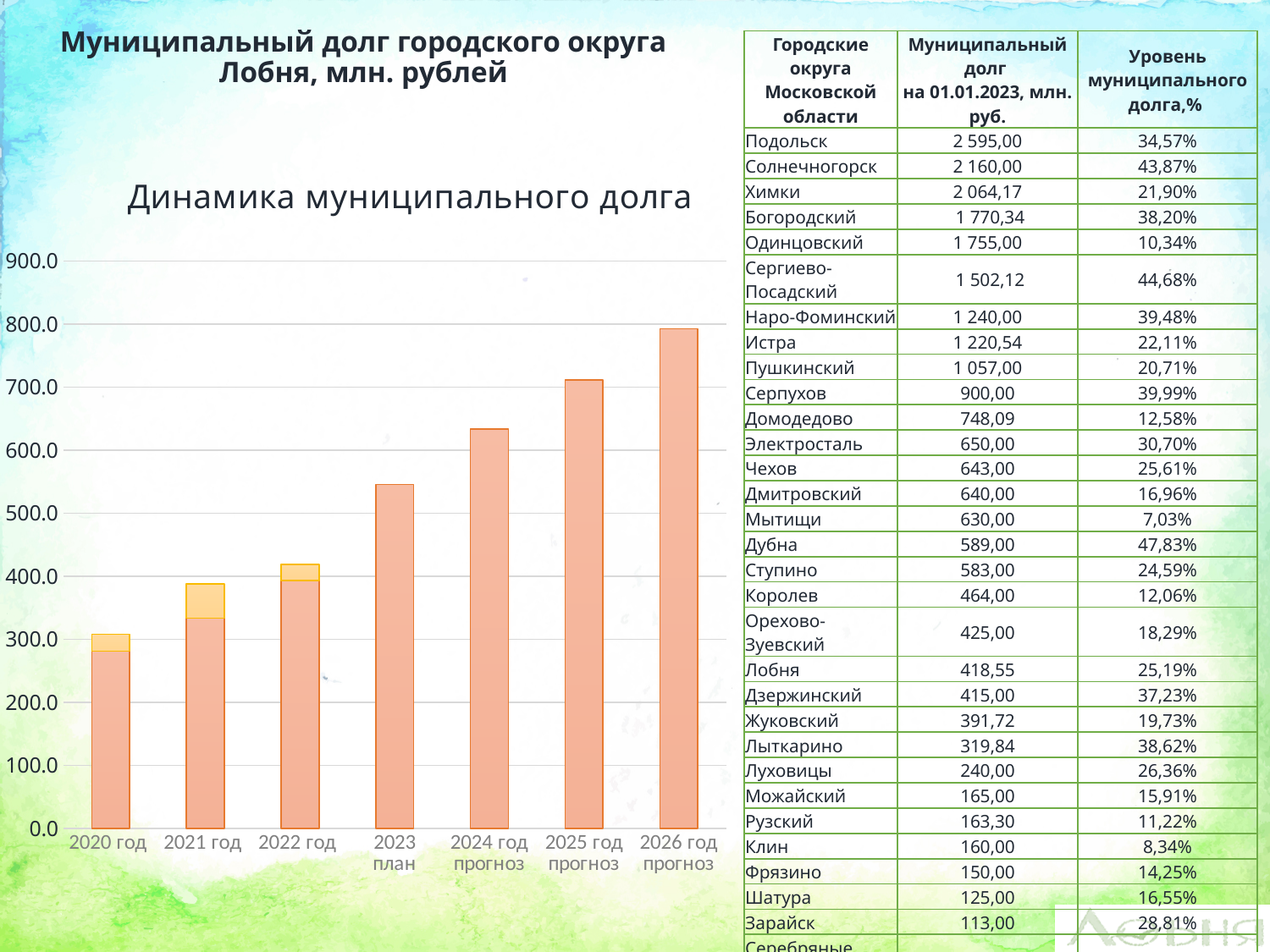
Do the bar values rise or fall from 2020 год to 2026 год прогноз? rise What is the title of the chart? Динамика муниципального долга Is the value for 2025 год прогноз greater or less than 800.0? less Is the value for 2026 год прогноз greater or less than 700.0? greater How many categories are shown on the x axis of the chart? 7 Which is larger, the bar for 2023 план or the bar for 2022 год? 2023 план What kind of chart is shown on the slide? bar chart Which category has the highest bar in the chart? 2026 год прогноз Is the value for 2020 год greater or less than 400.0? less Which category has the lowest bar in the chart? 2020 год